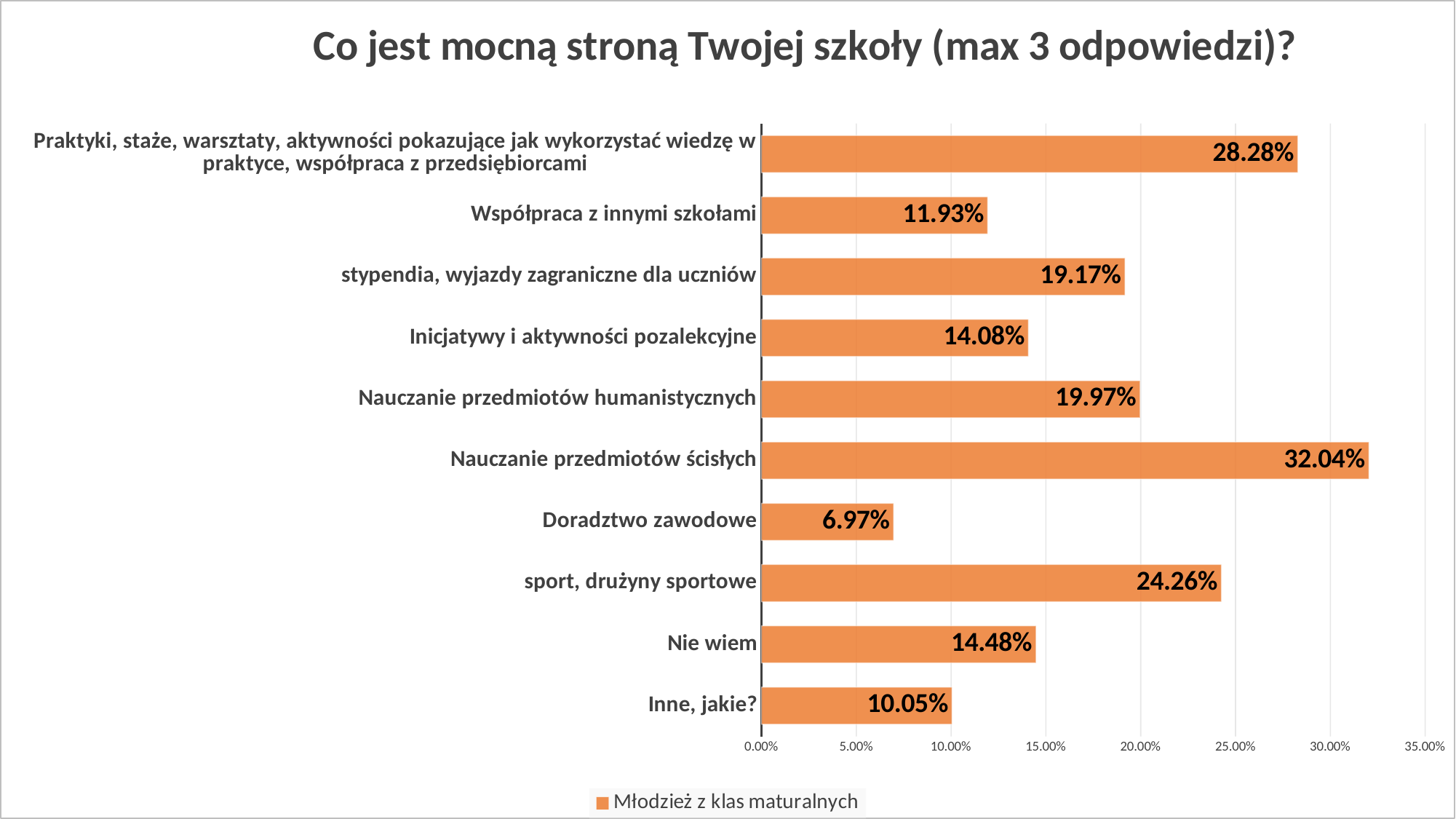
What is the value for "Nauczanie przedmiotów ścisłych"? 32.04% What is the value for "sport, drużyny sportowe"? 24.26% Which category has the highest value? Nauczanie przedmiotów ścisłych How many series does the legend list? 1 How many categories are shown in the chart? 10 Is the value for "stypendia, wyjazdy zagraniczne dla uczniów" greater or less than 20.00%? less What series name is shown in the legend? Młodzież z klas maturalnych What is the difference between "Nauczanie przedmiotów ścisłych" and "Nauczanie przedmiotów humanistycznych"? 12.07% What kind of chart is shown? bar chart What is the value for "Doradztwo zawodowe"? 6.97% Which is larger: "Współpraca z innymi szkołami" or "Inicjatywy i aktywności pozalekcyjne"? Inicjatywy i aktywności pozalekcyjne Which category has the lowest value? Doradztwo zawodowe